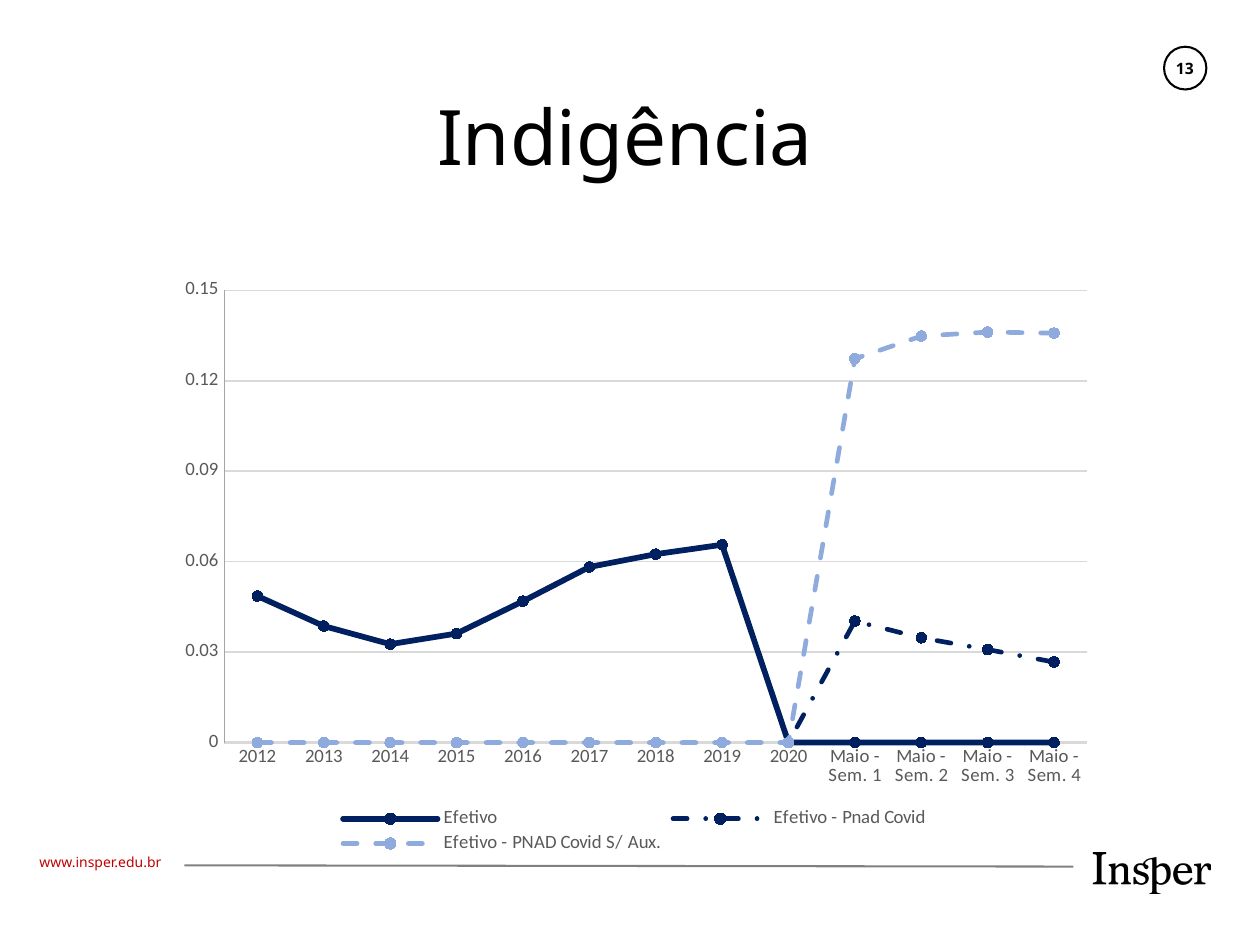
Is the Efetivo - Pnad Covid value for Maio - Sem. 4 greater or less than 0.03? less What is the Efetivo value for 2020? 0 How many categories are shown along the x axis? 13 Is the Efetivo - PNAD Covid S/ Aux. value for Maio - Sem. 2 greater or less than 0.12? greater Among the years 2012 to 2019, in which year is the Efetivo value lowest? 2014 How many series does the legend list? 3 What kind of chart is shown on the slide? line chart In which year does the Efetivo series reach its highest value? 2019 Is the Efetivo value for 2012 greater or less than 0.06? less Does the Efetivo - Pnad Covid series rise or fall from Maio - Sem. 1 to Maio - Sem. 4? fall At Maio - Sem. 1, which series has the larger value: Efetivo - Pnad Covid or Efetivo - PNAD Covid S/ Aux.? Efetivo - PNAD Covid S/ Aux.